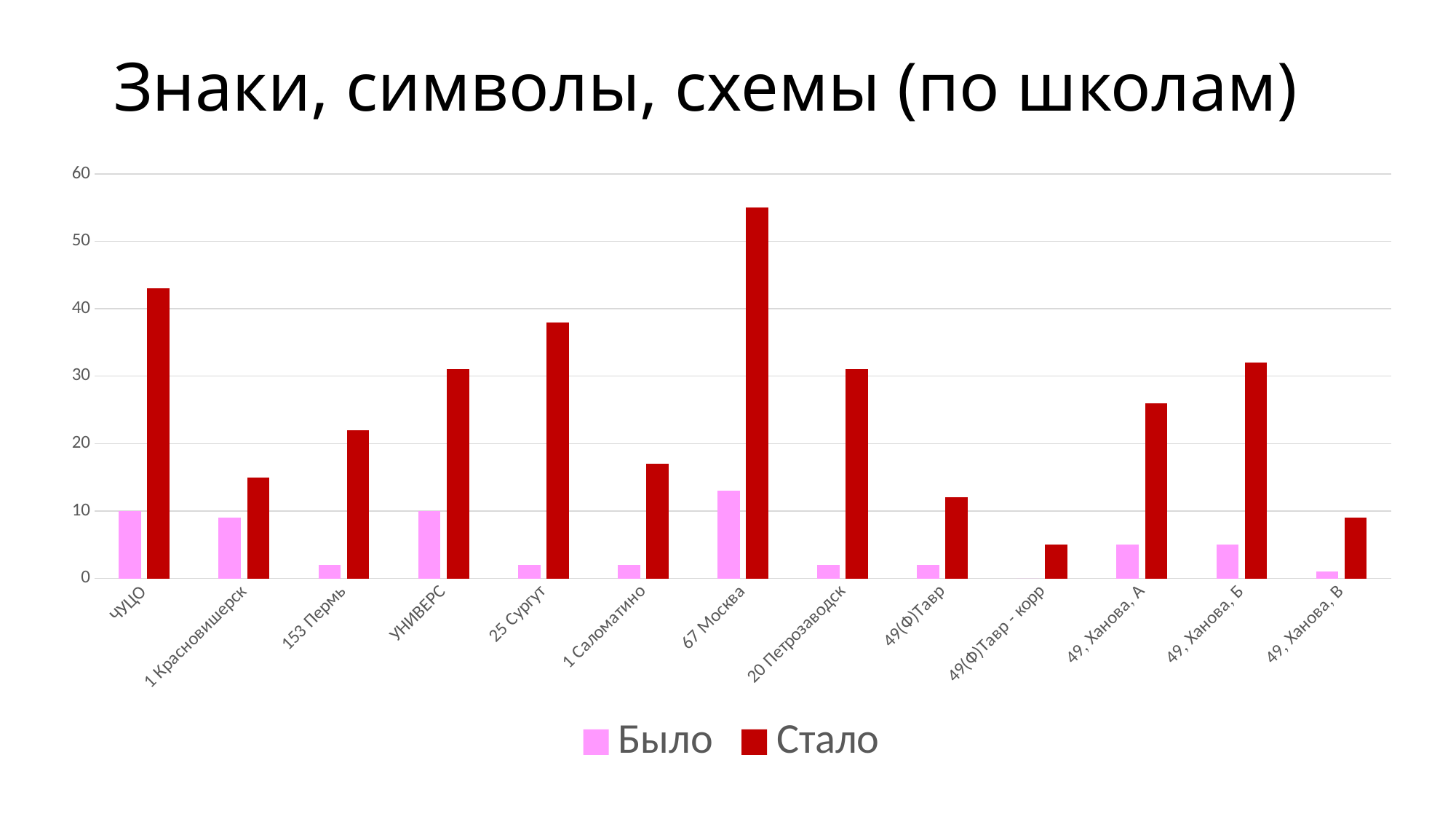
How many schools (categories) are shown on the x axis? 13 Is the Стало value for 1 Красновишерск greater or less than 10? greater Which school has the highest value for Было? 67 Москва What is the title of the chart? Знаки, символы, схемы (по школам) Which is larger: the Стало value for 25 Сургут or for 20 Петрозаводск? 25 Сургут What kind of chart is shown on the slide? bar chart Which is larger: the Стало value for 49, Ханова, А or for 49, Ханова, Б? 49, Ханова, Б Is the Стало value for 67 Москва greater or less than 50? greater Is the Стало value for ЧУЦО greater or less than 40? greater How many series does the legend list? 2 Which school has the lowest value for Стало? 49(Ф)Тавр - корр Which school has the highest value for Стало? 67 Москва